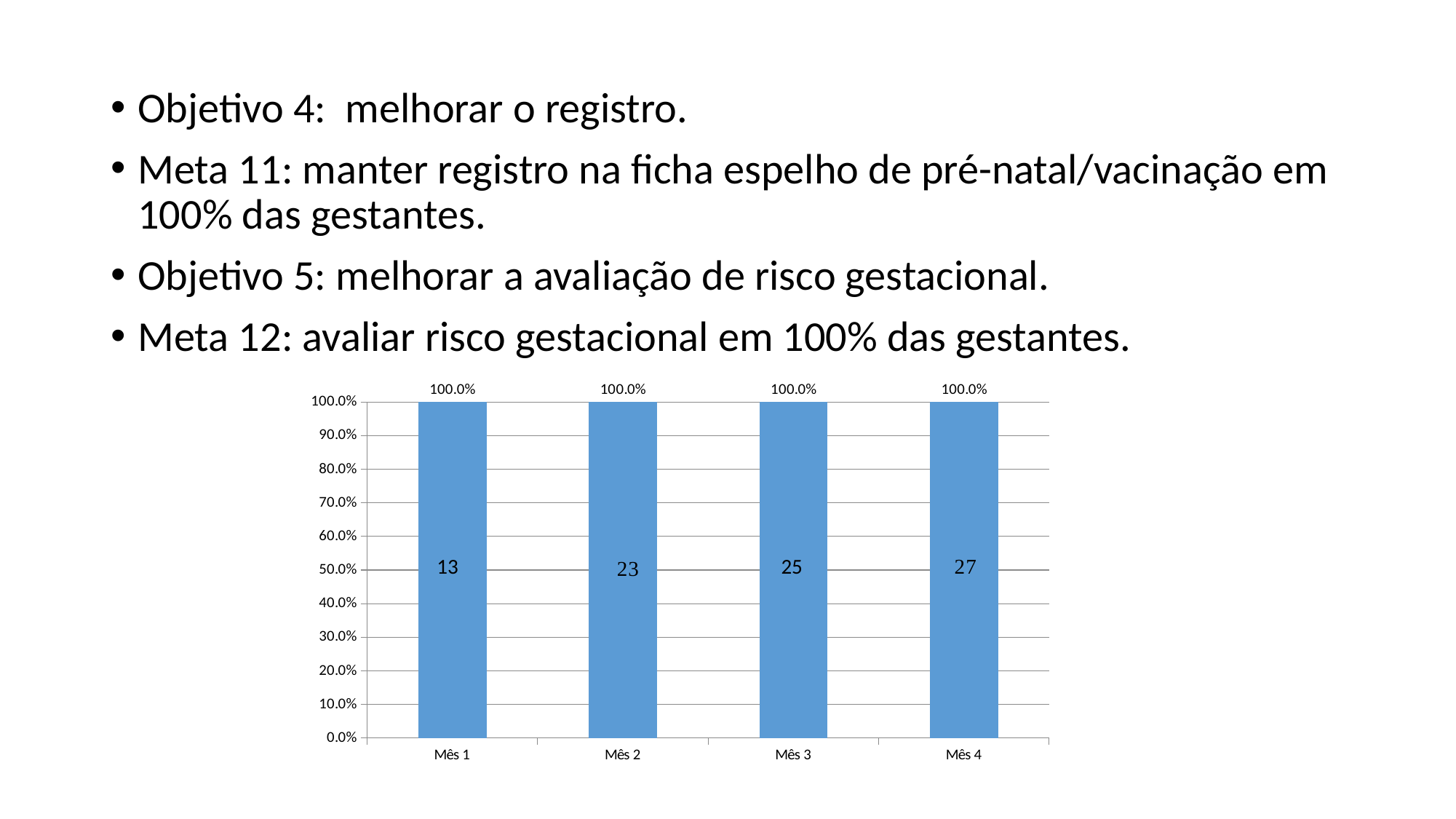
What number is printed inside the bar for Mês 4? 27 What percentage value is shown above the bar for Mês 4? 100.0% What percentage value is shown above the bar for Mês 1? 100.0% What number is printed inside the bar for Mês 3? 25 Is the percentage value for Mês 3 greater or less than 90.0%? greater What is the difference between the numbers printed inside the bars for Mês 4 and Mês 1? 14 What number is printed inside the bar for Mês 2? 23 Which has the larger number printed inside its bar, Mês 2 or Mês 4? Mês 4 What kind of chart is shown on the slide? Bar chart Do the percentage values rise, fall, or stay the same from Mês 1 to Mês 4? Stay the same How many categories (months) are shown on the x axis of the chart? 4 What number is printed inside the bar for Mês 1? 13